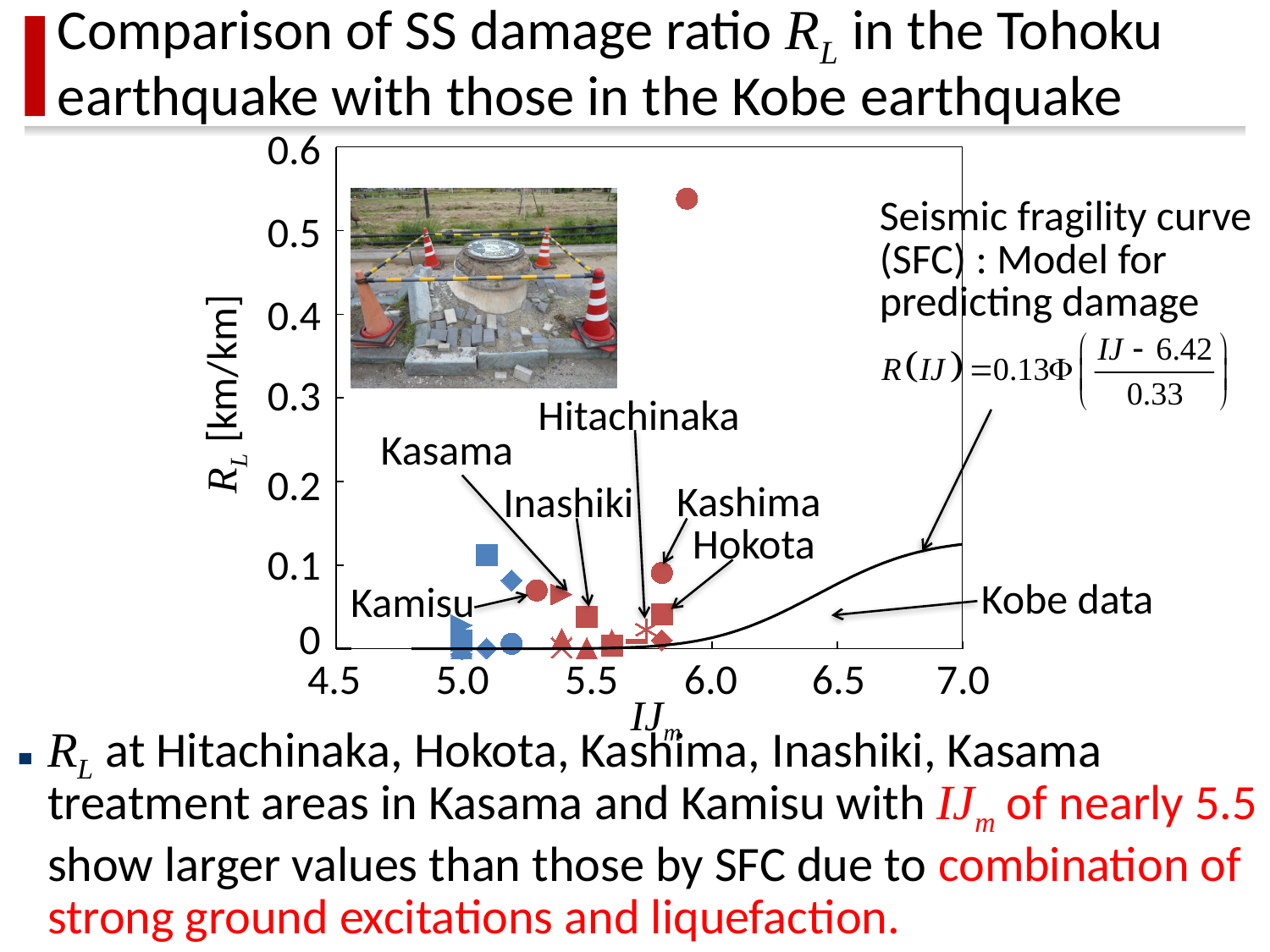
What is the unit shown on the y axis label of the chart? km/km Which has the larger R_L value, Kasama or Hitachinaka? Kasama Is the value of R_L for Hitachinaka greater or less than 0.1? less What is the range of the x axis (IJ_m) on the chart? 4.5 to 7.0 Which has the larger R_L value, Kashima or Hitachinaka? Kashima What kind of chart is shown on the slide? scatter chart Is the R_L value of the highest plotted point greater or less than 0.5? greater Is the value of R_L for Kashima greater or less than 0.2? less How many treatment areas are labelled by name on the chart? 6 Does the Kobe data curve rise or fall as IJ_m increases? rise